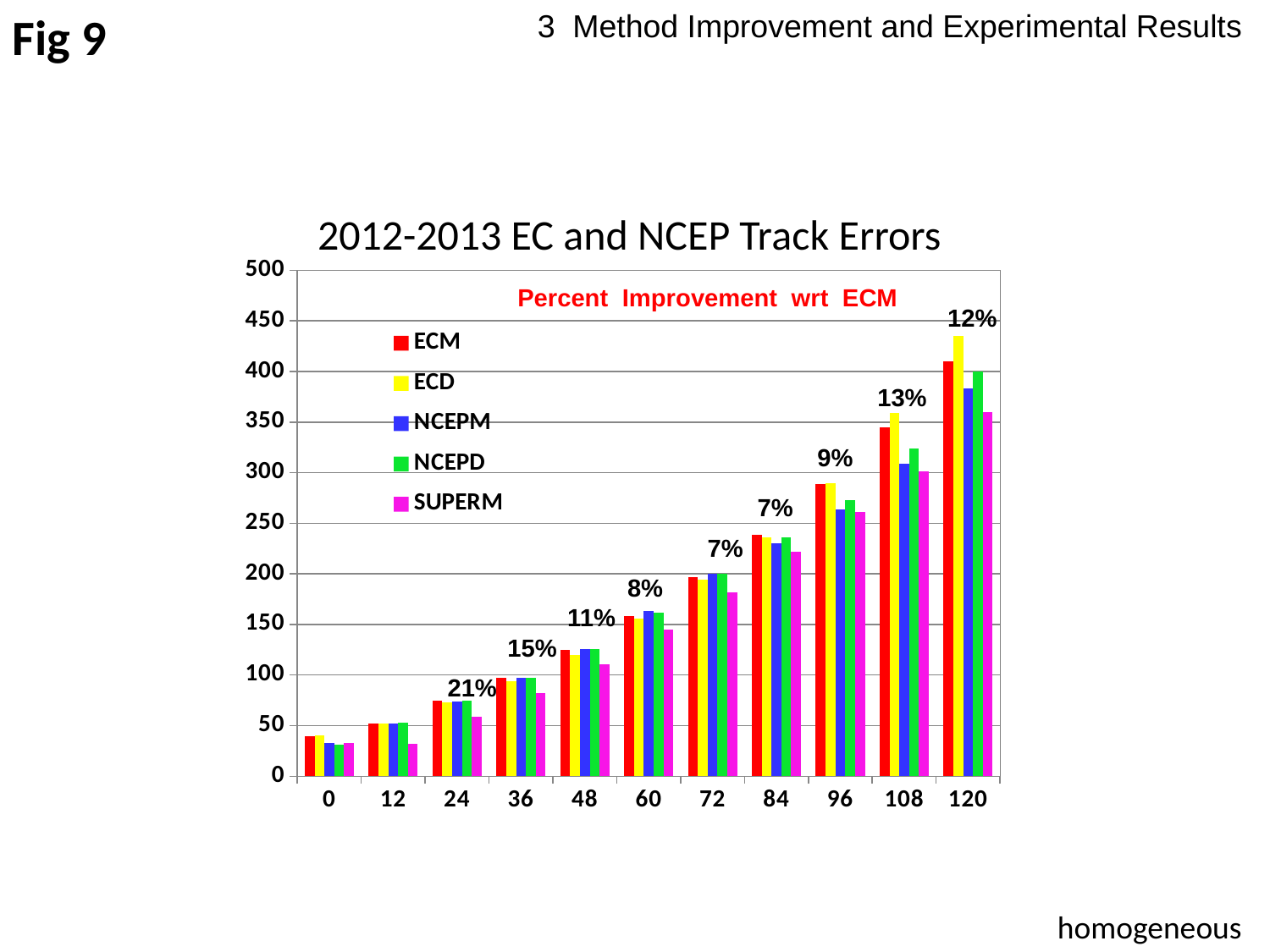
How many forecast-hour categories are shown on the x axis? 11 What percent improvement wrt ECM is labelled above the 24-hour group? 21% Is the ECD value at 120 hours greater or less than 400? greater What is the title of the chart? 2012-2013 EC and NCEP Track Errors Do the track errors rise or fall as the forecast hour increases along the x axis? rise Which forecast hour has the tallest ECM bar? 120 At 120 hours, which is larger, the ECD bar or the SUPERM bar? ECD Is the SUPERM value at 120 hours greater or less than 400? less Which forecast hour has the highest percent improvement label? 24 What percent improvement wrt ECM is labelled above the 108-hour group? 13% How many series does the legend list? 5 What kind of chart is shown on the slide? bar chart